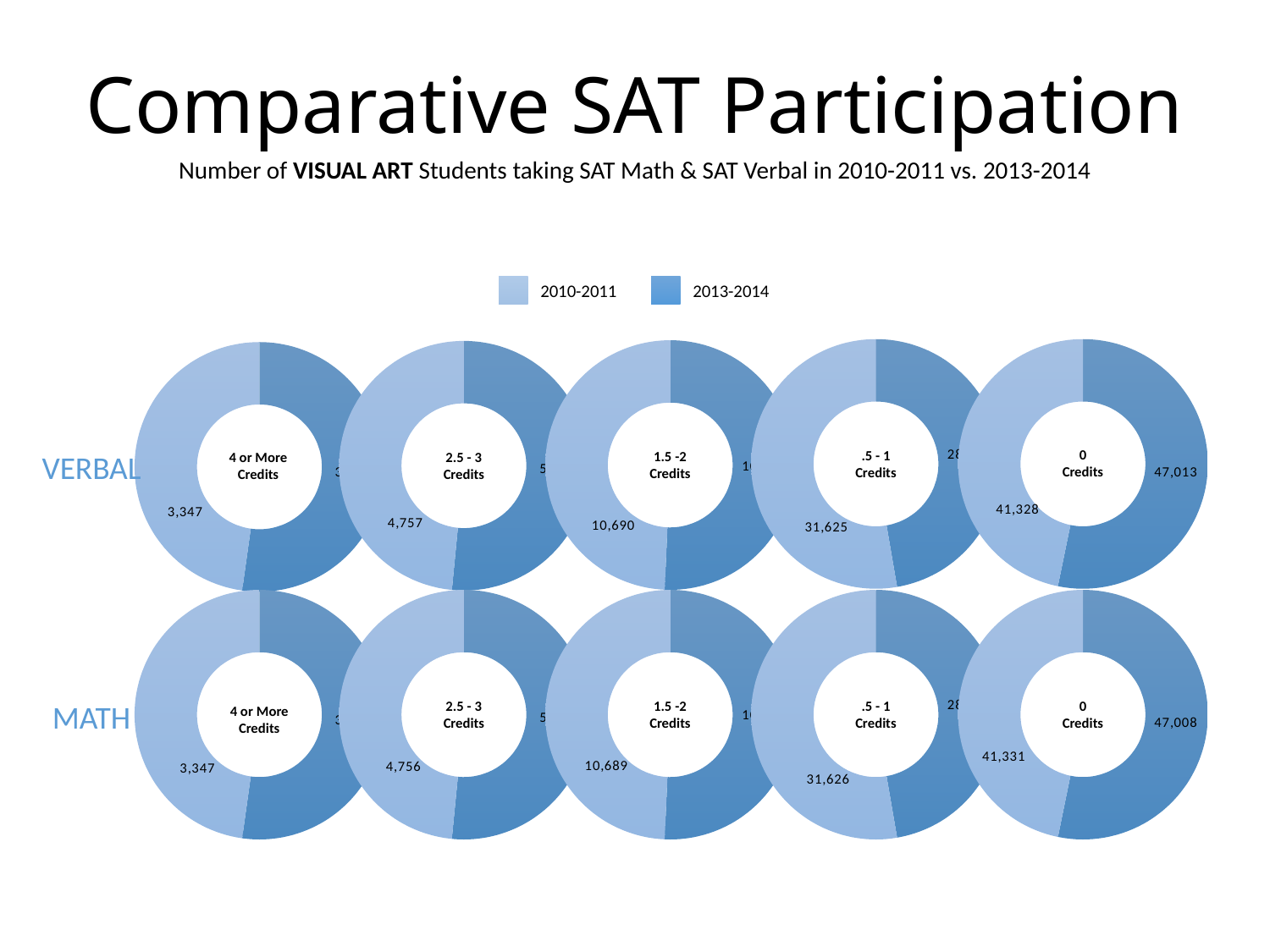
In the MATH row '0 Credits' donut chart, what is the difference between the 2013-2014 value and the 2010-2011 value? 5,677 In the VERBAL row, what is the 2010-2011 value shown on the '4 or More Credits' donut chart? 3,347 In the MATH row, what is the 2010-2011 value shown on the '.5 - 1 Credits' donut chart? 31,626 In the VERBAL row, what is the 2013-2014 value shown on the '0 Credits' donut chart? 47,013 In the VERBAL row '0 Credits' donut chart, which series has the larger value, 2010-2011 or 2013-2014? 2013-2014 How many series does the legend list? 2 In the MATH row, what is the 2010-2011 value shown on the '0 Credits' donut chart? 41,331 In the VERBAL row, what is the 2010-2011 value shown on the '1.5 -2 Credits' donut chart? 10,690 In the MATH row, what is the 2013-2014 value shown on the '0 Credits' donut chart? 47,008 In the VERBAL row, what is the 2010-2011 value shown on the '.5 - 1 Credits' donut chart? 31,625 What kind of chart is used on this slide? Donut (pie) chart In the VERBAL row, what is the 2010-2011 value shown on the '2.5 - 3 Credits' donut chart? 4,757